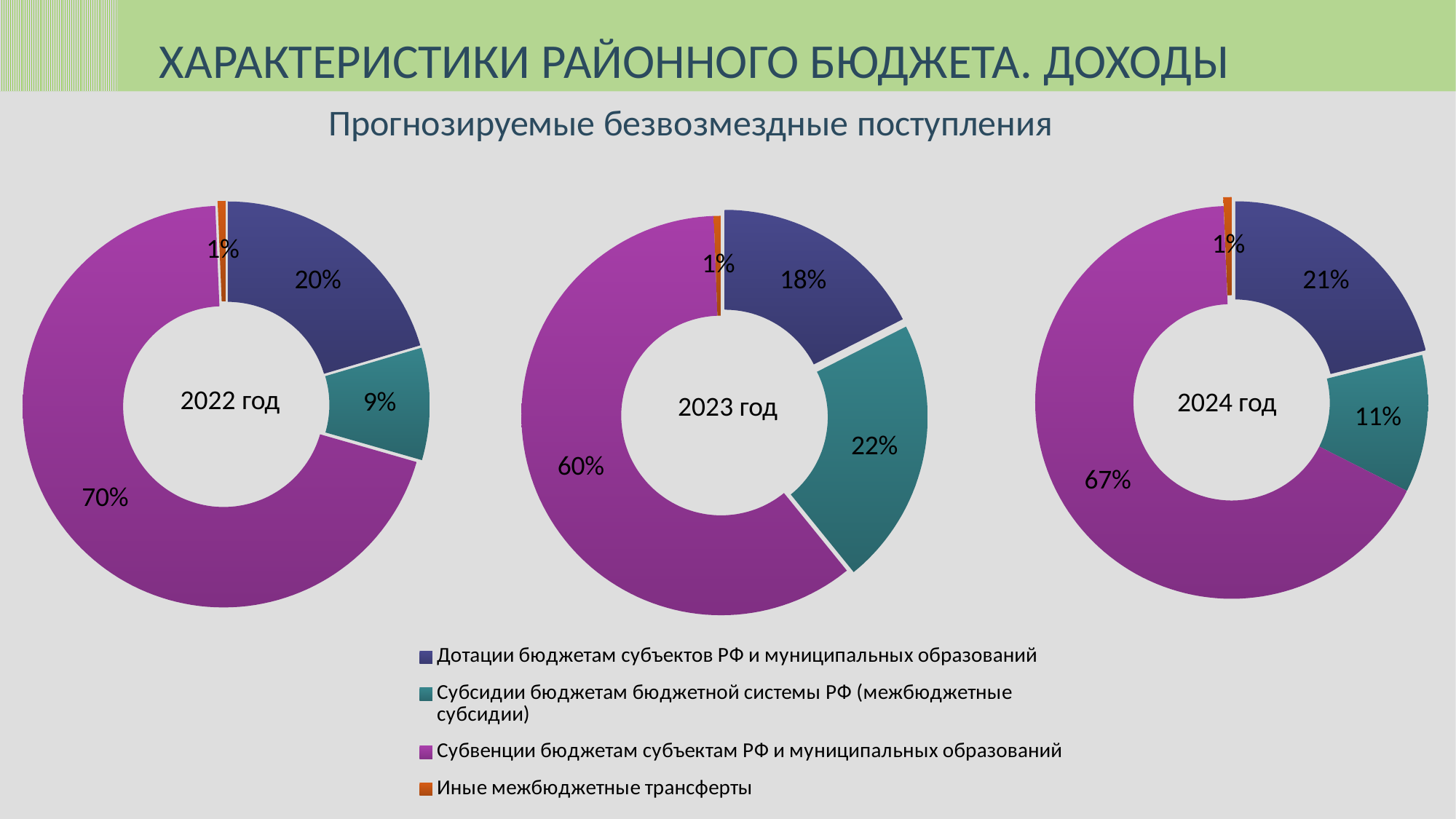
What colour represents Субвенции бюджетам субъектам РФ и муниципальных образований in the charts? Purple How many charts are shown on the slide? 3 What kind of chart is used for the 2023 год data? Doughnut (pie) chart In the 2024 год chart, which is larger: the share for Дотации or the share for Субсидии? Дотации In the 2023 год chart, which category has the largest share? Субвенции бюджетам субъектам РФ и муниципальных образований In the 2022 год chart, what is the difference between the shares for Дотации and Субсидии? 11% In the 2022 год chart, what share is shown for Субвенции бюджетам субъектам РФ и муниципальных образований? 70% In the 2023 год chart, what share is shown for Субсидии бюджетам бюджетной системы РФ (межбюджетные субсидии)? 22% How many categories does the legend list? 4 In the 2024 год chart, which category has the smallest share? Иные межбюджетные трансферты In the 2024 год chart, what share is shown for Дотации бюджетам субъектов РФ и муниципальных образований? 21% In the 2022 год chart, what share is shown for Иные межбюджетные трансферты? 1%